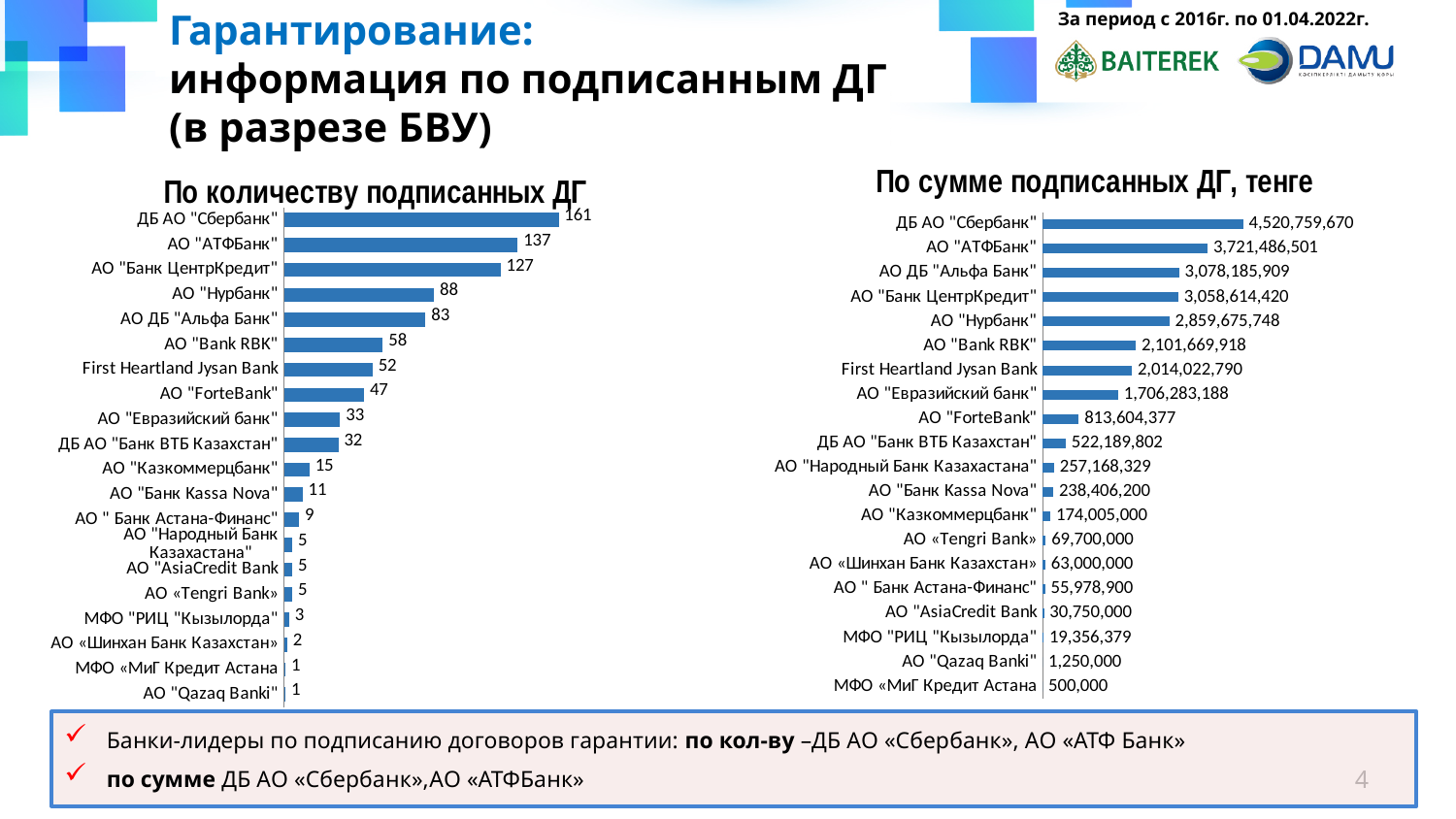
In the chart 'По сумме подписанных ДГ, тенге', which category has the lowest value? МФО «МиГ Кредит Астана In the chart 'По сумме подписанных ДГ, тенге', which is larger: АО "Bank RBK" or АО "ForteBank"? АО "Bank RBK" In the chart 'По количеству подписанных ДГ', which category has the highest value? ДБ АО "Сбербанк" How many categories are shown in the chart 'По количеству подписанных ДГ'? 20 In the chart 'По сумме подписанных ДГ, тенге', what is the difference between ДБ АО "Сбербанк" and АО "АТФБанк"? 799,273,169 How many categories are shown in the chart 'По сумме подписанных ДГ, тенге'? 20 In the chart 'По сумме подписанных ДГ, тенге', what is the value for АО "Нурбанк"? 2,859,675,748 What type of chart is 'По сумме подписанных ДГ, тенге'? Bar chart In the chart 'По количеству подписанных ДГ', what is the value for АО "Евразийский банк"? 33 In the chart 'По количеству подписанных ДГ', what is the value for АО "АТФБанк"? 137 In the chart 'По количеству подписанных ДГ', which is larger: АО "Нурбанк" or АО "Bank RBK"? АО "Нурбанк" In the chart 'По количеству подписанных ДГ', what is the difference between ДБ АО "Сбербанк" and АО "АТФБанк"? 24